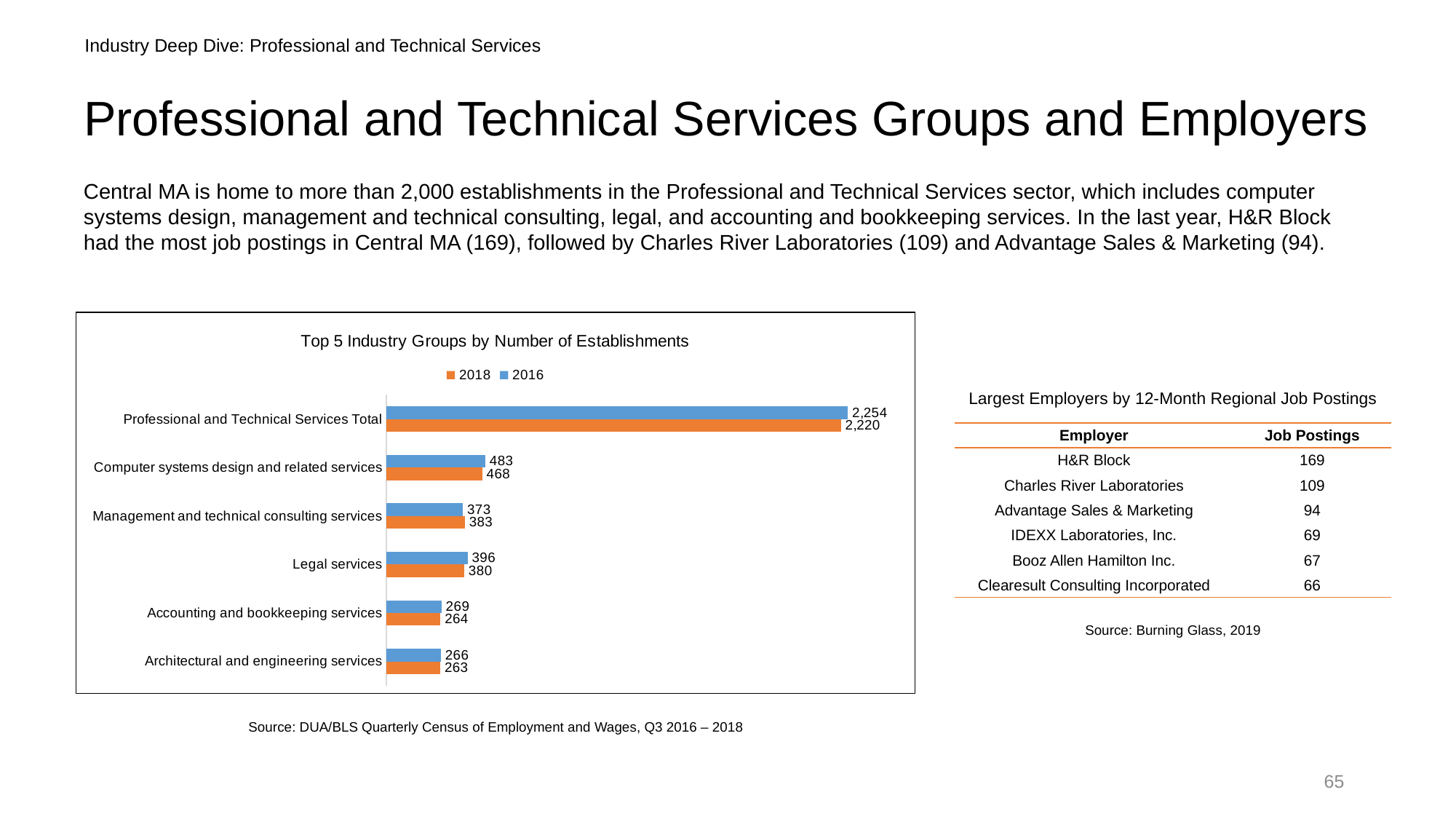
How many series does the chart's legend list? 2 What is the title of the chart? Top 5 Industry Groups by Number of Establishments What is the 2016 value for Computer systems design and related services? 483 Excluding the Total, which industry group has the highest 2018 value? Computer systems design and related services What is the 2018 value for Legal services? 380 What kind of chart is shown on the slide? bar chart How many categories are plotted on the chart? 6 What is the difference between the 2016 and 2018 values for Computer systems design and related services? 15 Which industry group has the lowest 2018 value? Architectural and engineering services What is the 2016 value for Management and technical consulting services? 373 What is the 2018 value for Professional and Technical Services Total? 2,220 For Management and technical consulting services, which is larger, the 2016 value or the 2018 value? 2018